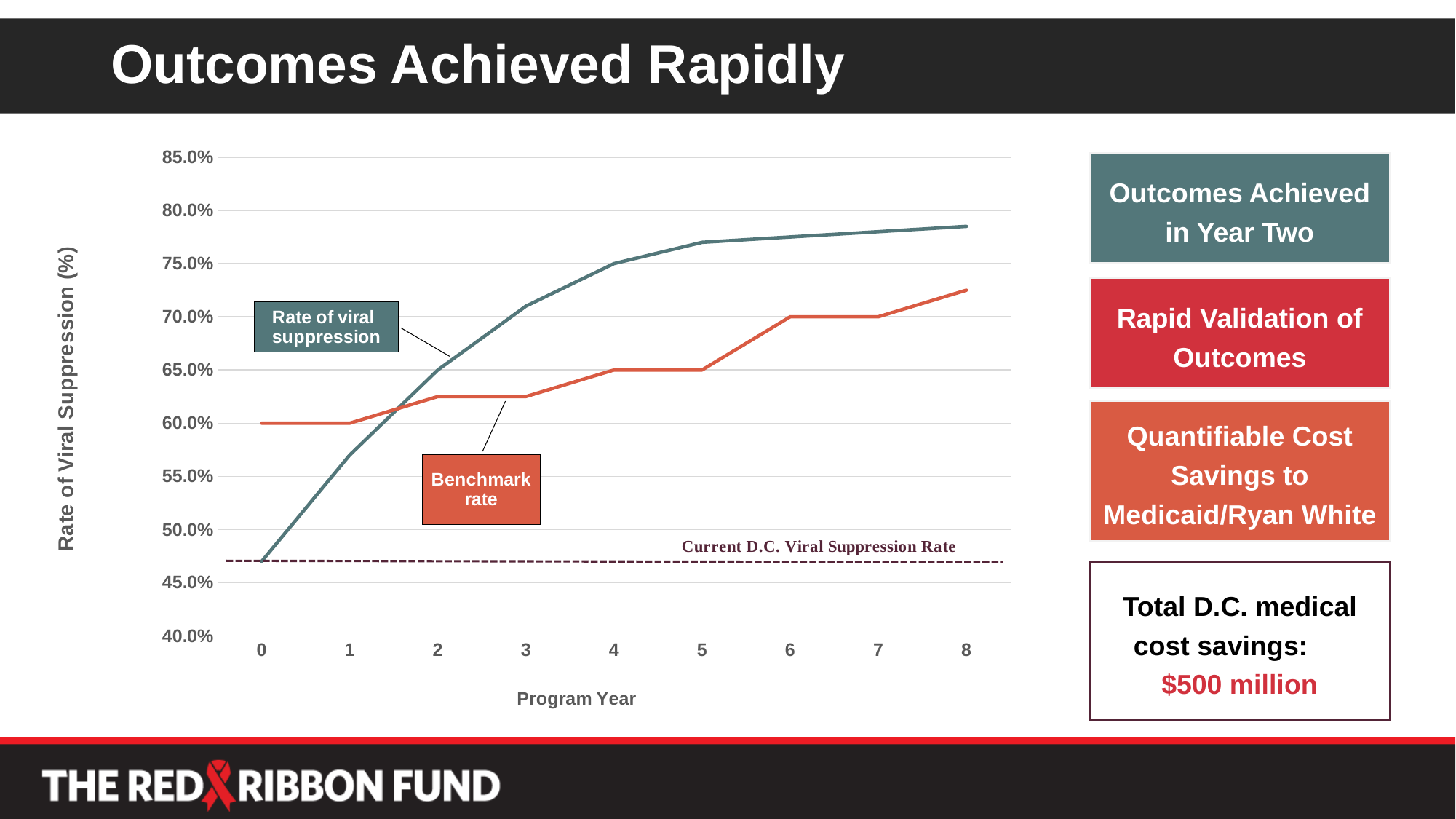
At program year 8, which line is higher: Rate of viral suppression or Benchmark rate? Rate of viral suppression Is the Current D.C. Viral Suppression Rate dashed line greater or less than 50.0%? less Is the Rate of viral suppression at program year 8 greater or less than 75.0%? greater What is the Benchmark rate at program year 0? 60.0% What is the Benchmark rate at program year 6? 70.0% How many program years are plotted along the x axis? 9 What kind of chart is shown on the slide? line chart At program year 0, which line is higher: Rate of viral suppression or Benchmark rate? Benchmark rate What is the title of the x axis of the chart? Program Year Does the Rate of viral suppression line rise or fall from program year 0 to program year 8? rise What is the Benchmark rate at program year 4? 65.0% Is the Rate of viral suppression at program year 1 greater or less than 60.0%? less